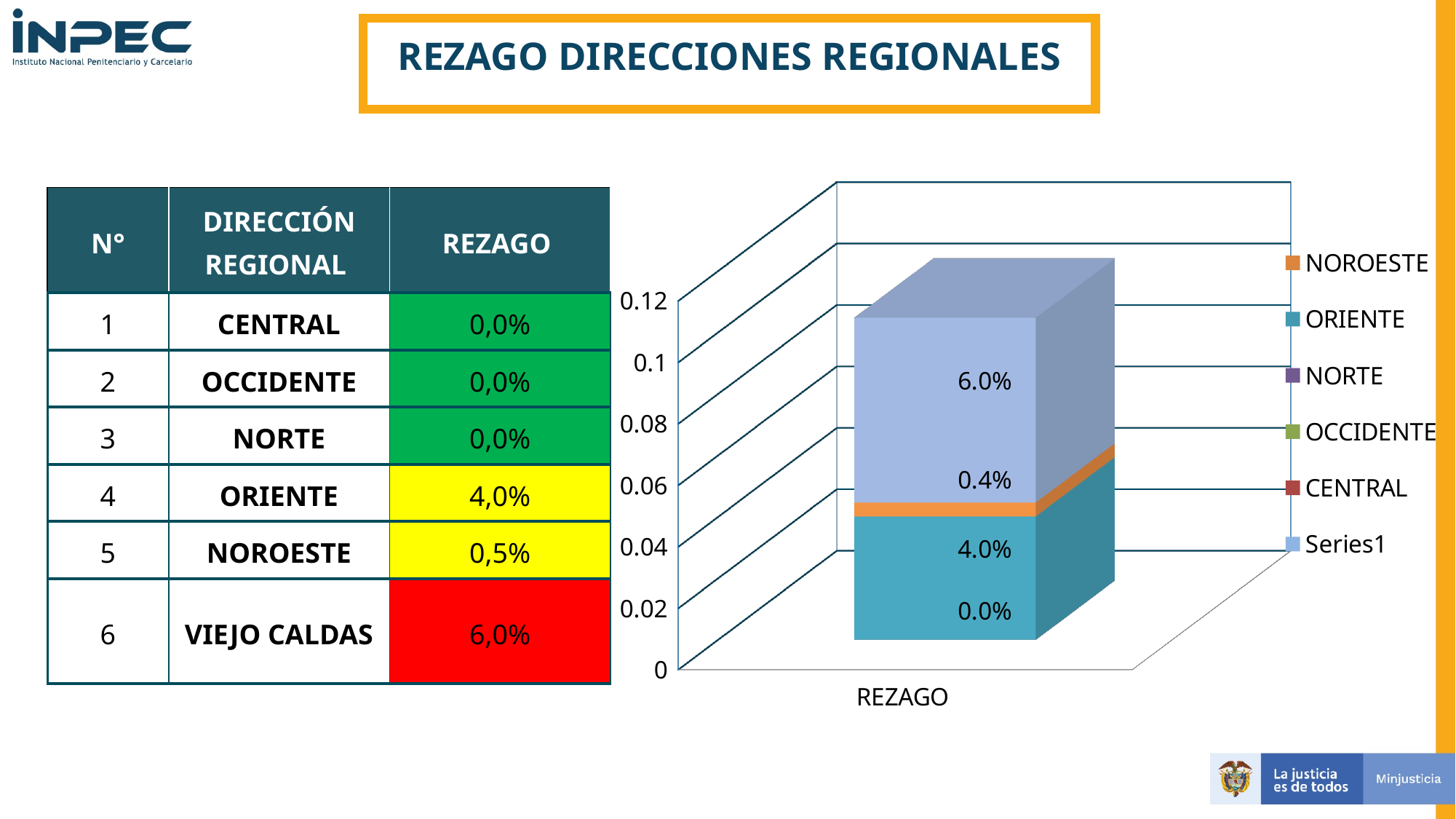
What value is printed on the Series1 (light blue) segment of the bar? 6.0% What kind of chart is shown on the slide? stacked bar chart How many categories are plotted on the x axis of the chart? 1 What colour is the legend marker for NOROESTE? orange What value is printed on the NOROESTE (orange) segment of the bar? 0.4% Is the top of the stacked bar greater or less than 0.1 on the vertical axis? greater What value is printed on the ORIENTE (teal) segment of the bar? 4.0% Which is larger, the ORIENTE segment or the NOROESTE segment? ORIENTE What is the label of the single category on the chart's x axis? REZAGO Which series has the largest segment in the stacked bar? Series1 How many series does the chart legend list? 6 What is the difference between the Series1 segment (6.0%) and the ORIENTE segment (4.0%)? 2.0%